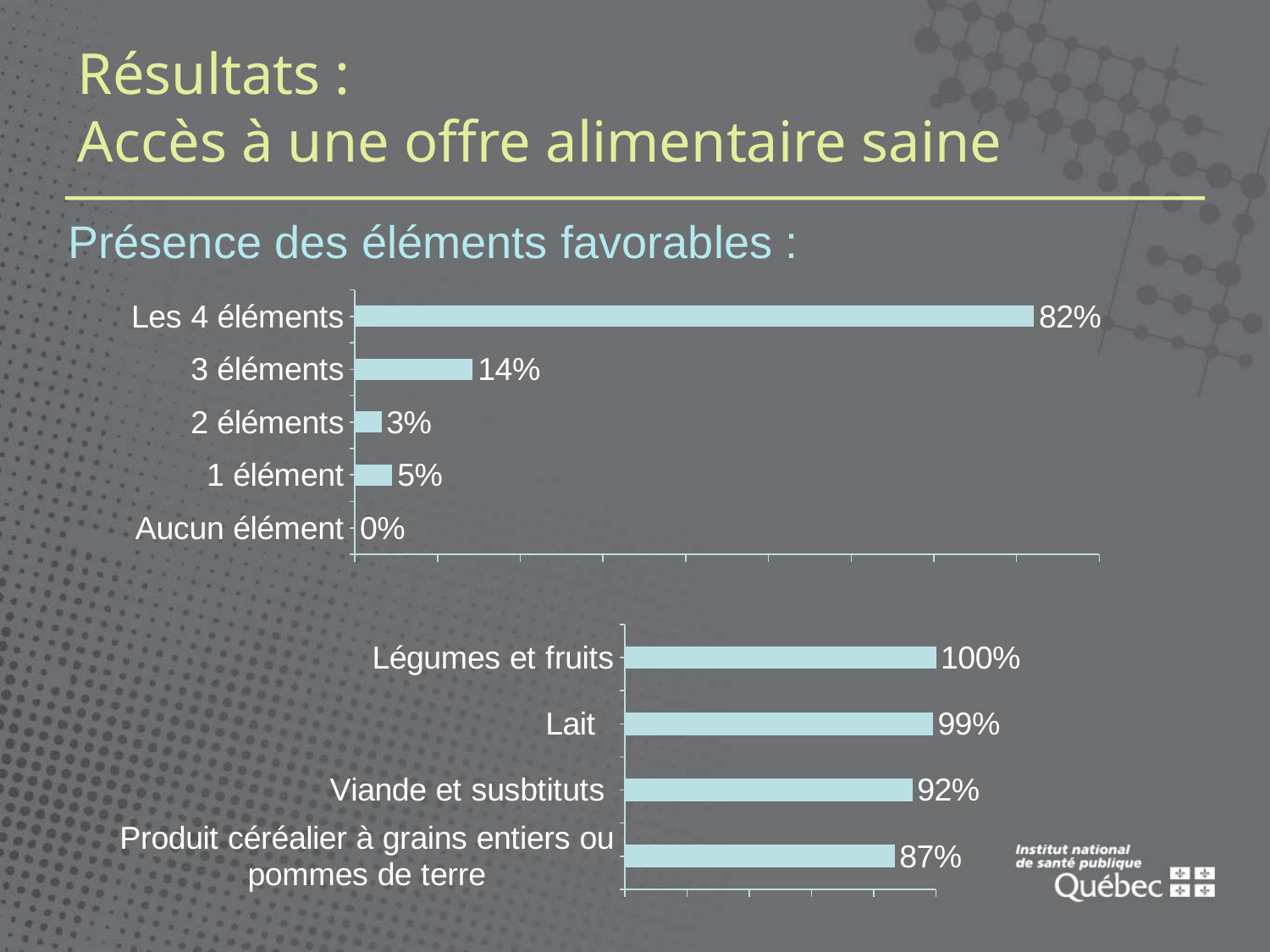
In the bottom chart, what is the value for 'Lait'? 99% What kind of chart is the bottom chart? Bar chart In the top chart, what is the value for 'Les 4 éléments'? 82% In the top chart, how many categories are shown? 5 In the bottom chart, which category has the highest value? Légumes et fruits In the top chart, which category has the lowest value? Aucun élément In the top chart, which is larger: '2 éléments' or '1 élément'? 1 élément In the top chart, what is the value for '3 éléments'? 14% What is the subtitle shown above the charts? Présence des éléments favorables : In the bottom chart, what is the difference between 'Viande et susbtituts' and 'Produit céréalier à grains entiers ou pommes de terre'? 5% In the top chart, what is the difference between 'Les 4 éléments' and '3 éléments'? 68% In the bottom chart, what is the value for 'Produit céréalier à grains entiers ou pommes de terre'? 87%